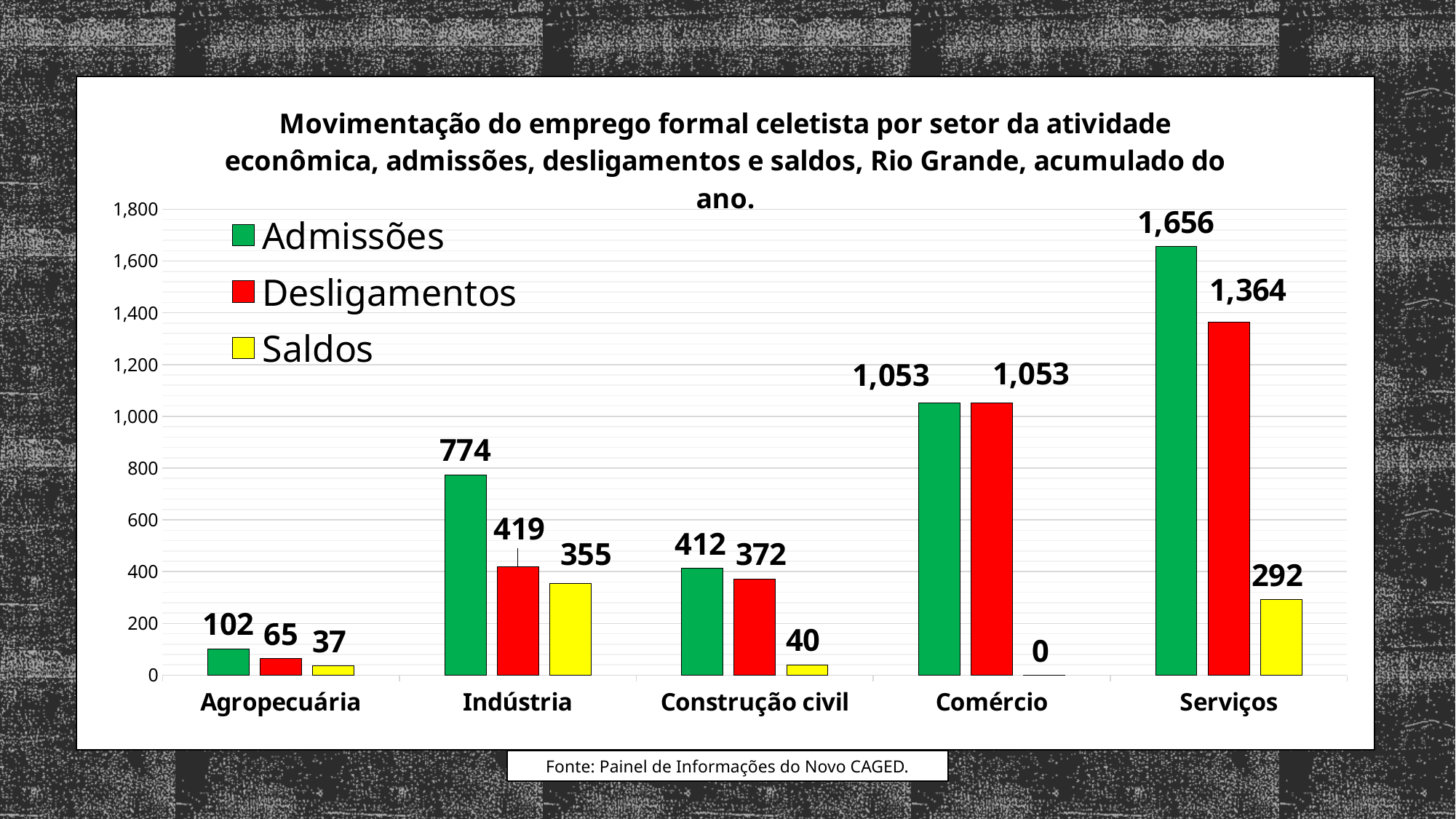
What is the value of Desligamentos for Indústria? 419 Which colour represents the Saldos series? Yellow What kind of chart is shown on the slide? Bar chart Which sector has the lowest value for Desligamentos? Agropecuária What is the value of Admissões for Serviços? 1,656 Which is larger for Construção civil, Admissões or Desligamentos? Admissões Which sector has the highest value for Admissões? Serviços What is the value of Saldos for Comércio? 0 What is the value of Saldos for Construção civil? 40 How many series does the legend list? 3 What is the difference between Admissões and Desligamentos for Indústria? 355 How many sectors are shown on the x axis? 5